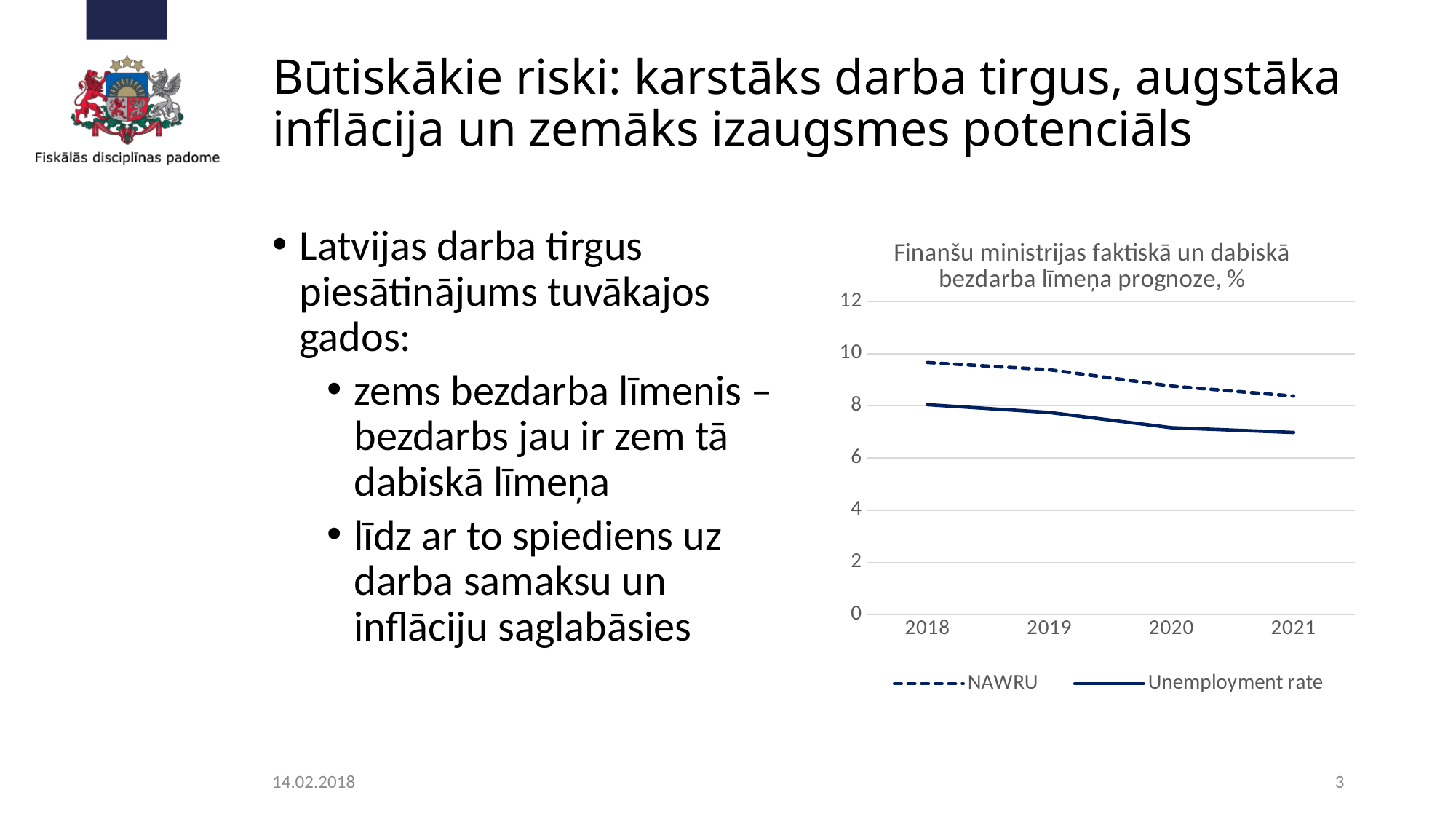
How many years are shown on the x axis of the chart? 4 In which year is the NAWRU value highest? 2018 In which year is the Unemployment rate lowest? 2021 How many series does the chart legend list? 2 In 2018, which is higher: NAWRU or Unemployment rate? NAWRU Is the NAWRU value for 2018 greater or less than 8? greater What kind of chart is shown on the slide? line chart What is the title of the chart? Finanšu ministrijas faktiskā un dabiskā bezdarba līmeņa prognoze, % Does the NAWRU line rise or fall from 2018 to 2021? fall Is the Unemployment rate value for 2021 greater or less than 8? less Does the Unemployment rate line rise or fall from 2018 to 2021? fall Which series is drawn with a dashed line? NAWRU